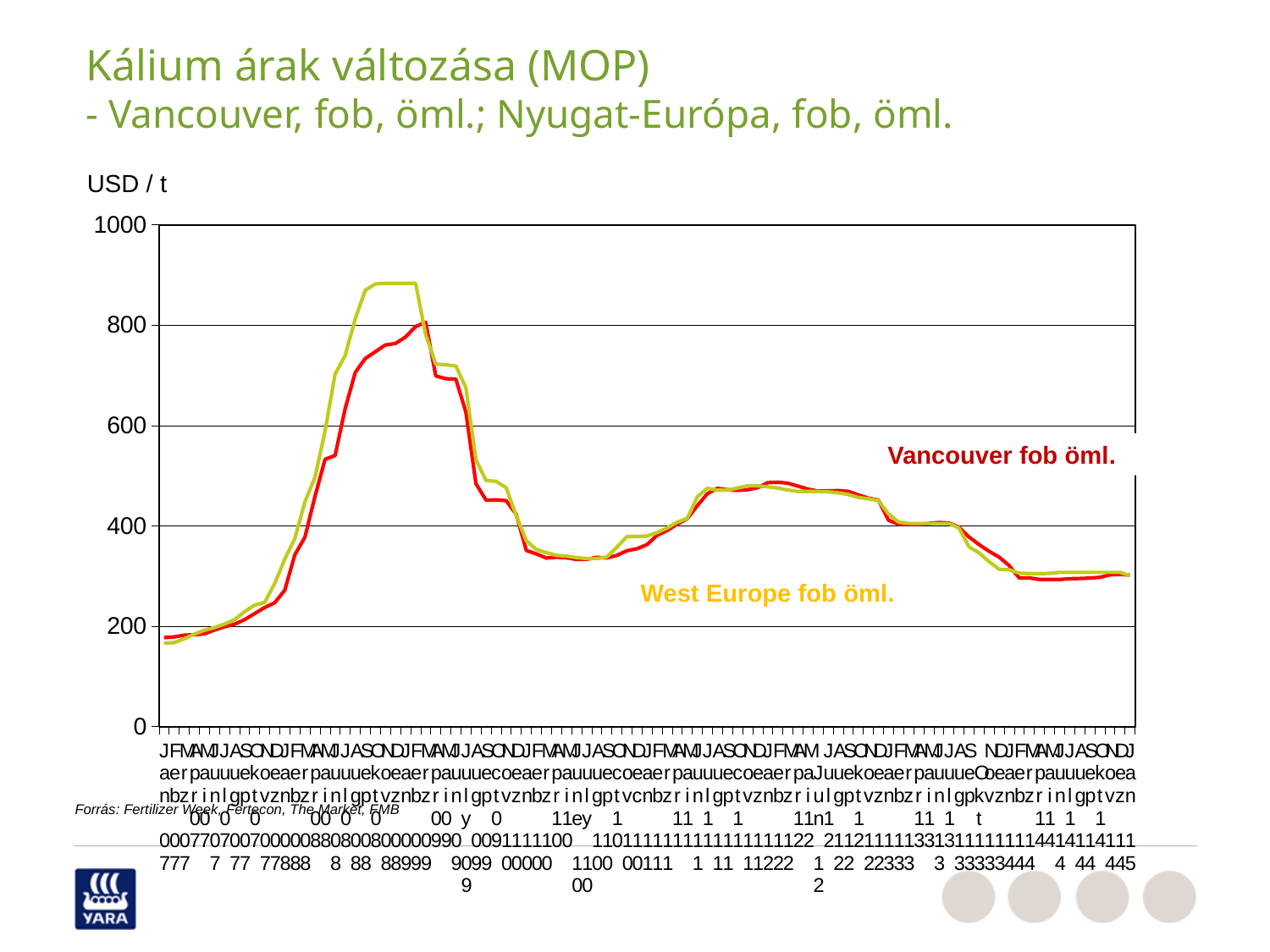
Which series is drawn in red? Vancouver fob öml. Is the value of the Vancouver fob öml. series at the start of the chart greater or less than 200? less From the left end of the x axis up to the peak, do the values rise or fall? rise What kind of chart is shown on the slide? line chart Is the value of the West Europe fob öml. series at the end of the chart greater or less than 400? less Which series reaches the higher peak value, Vancouver fob öml. or West Europe fob öml.? West Europe fob öml. Is the peak value of the West Europe fob öml. series greater or less than 800? greater From the peak of the chart to the right end of the x axis, do the values rise or fall overall? fall What unit is shown on the vertical axis of the chart? USD / t How many series are plotted on the chart? 2